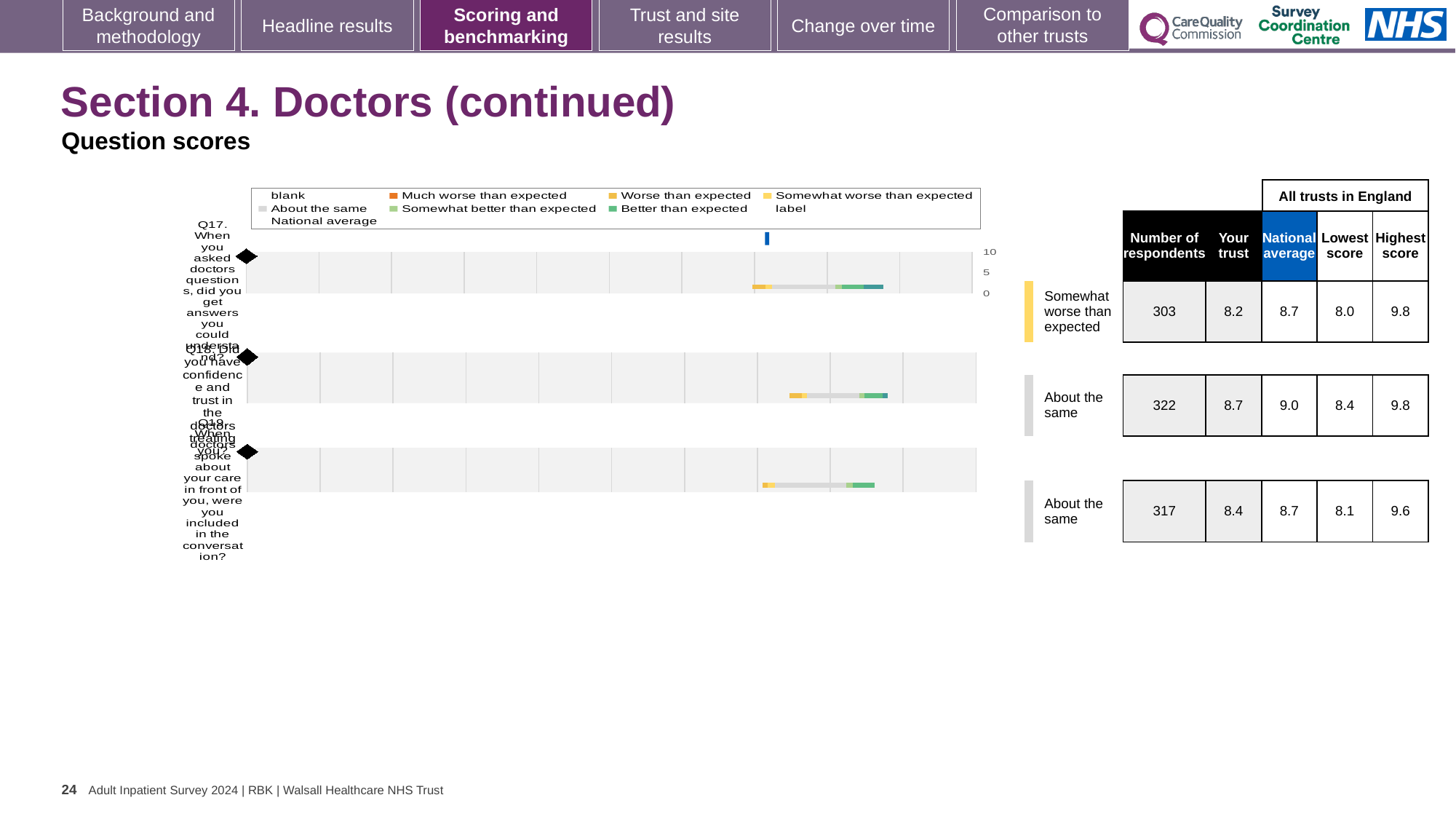
By how much does the national average for Q17 exceed the 'Your trust' score for Q17? 0.5 Which benchmark category is Q17 assigned to on the slide? Somewhat worse than expected How many questions (categories) are plotted in the chart? 3 What is the 'Your trust' score for Q17 in the table beside the chart? 8.2 What is the highest tick value shown on the chart's axis? 10 What kind of chart is shown on the slide? bar chart What is the highest score across all trusts in England for Q19? 9.6 Which question has the highest 'Your trust' score in the table beside the chart? Q18 What colour does the legend use for 'Much worse than expected'? orange Which question has the lowest number of respondents in the table beside the chart? Q17 For Q19, which is larger: the 'Your trust' score or the national average? National average What is the national average for Q18 in the table beside the chart? 9.0